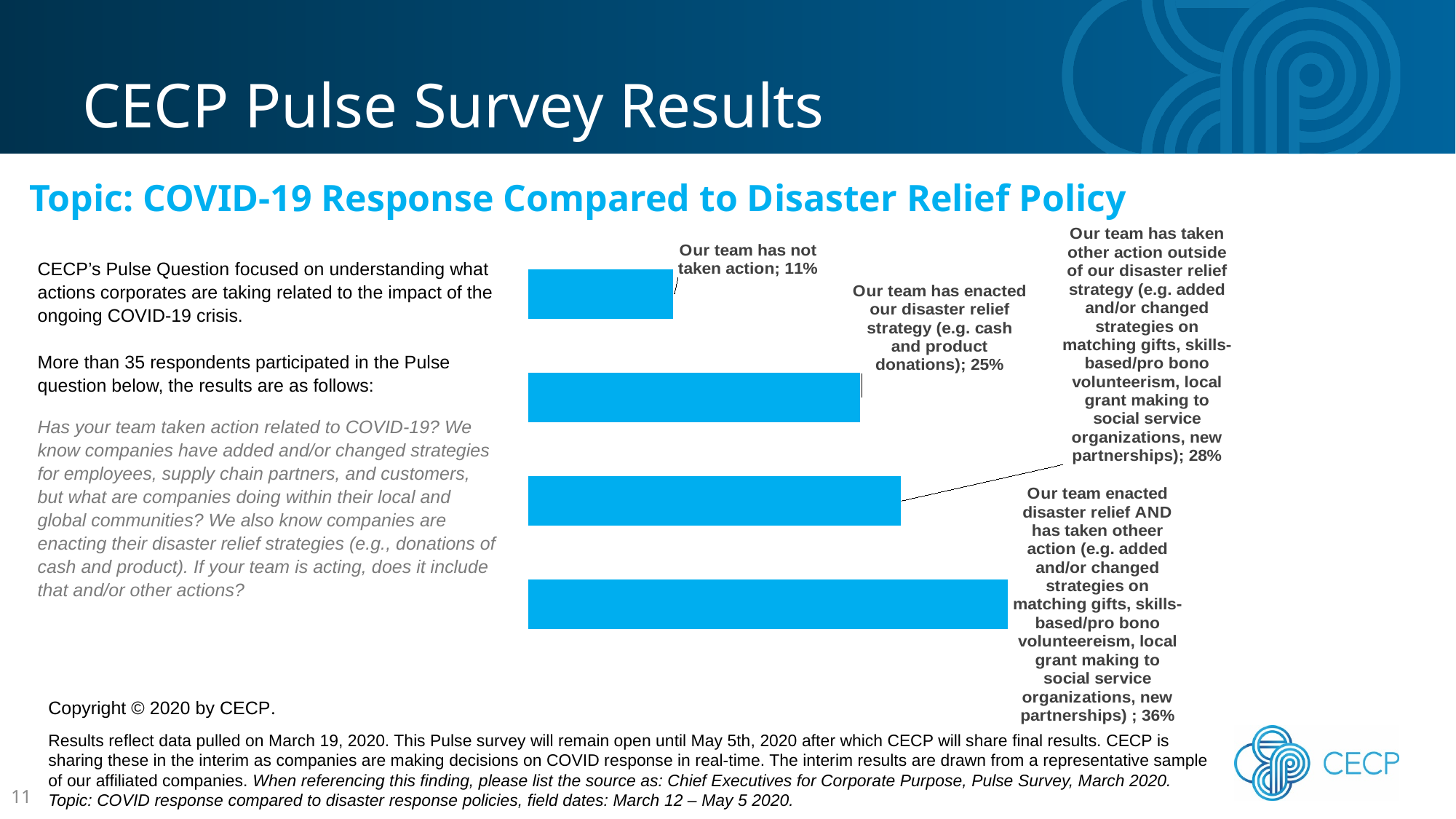
What percentage of respondents said their team has not taken action? 11% What percentage of respondents said their team enacted disaster relief AND has taken other action? 36% What percentage of respondents said their team has taken other action outside of its disaster relief strategy? 28% What percentage of respondents said their team has enacted its disaster relief strategy (e.g. cash and product donations)? 25% How many bars are shown in the chart? 4 What type of chart is shown on the slide? Bar chart What colour are the bars in the chart? Blue Which response has the highest percentage in the chart? Our team enacted disaster relief AND has taken other action What is the difference in percentage points between 'Our team enacted disaster relief AND has taken other action' and 'Our team has not taken action'? 25 Which is larger: the percentage for 'Our team has enacted our disaster relief strategy' or for 'Our team has not taken action'? Our team has enacted our disaster relief strategy Which response has the lowest percentage in the chart? Our team has not taken action What is the difference in percentage points between 'Our team has taken other action outside of our disaster relief strategy' and 'Our team has enacted our disaster relief strategy'? 3